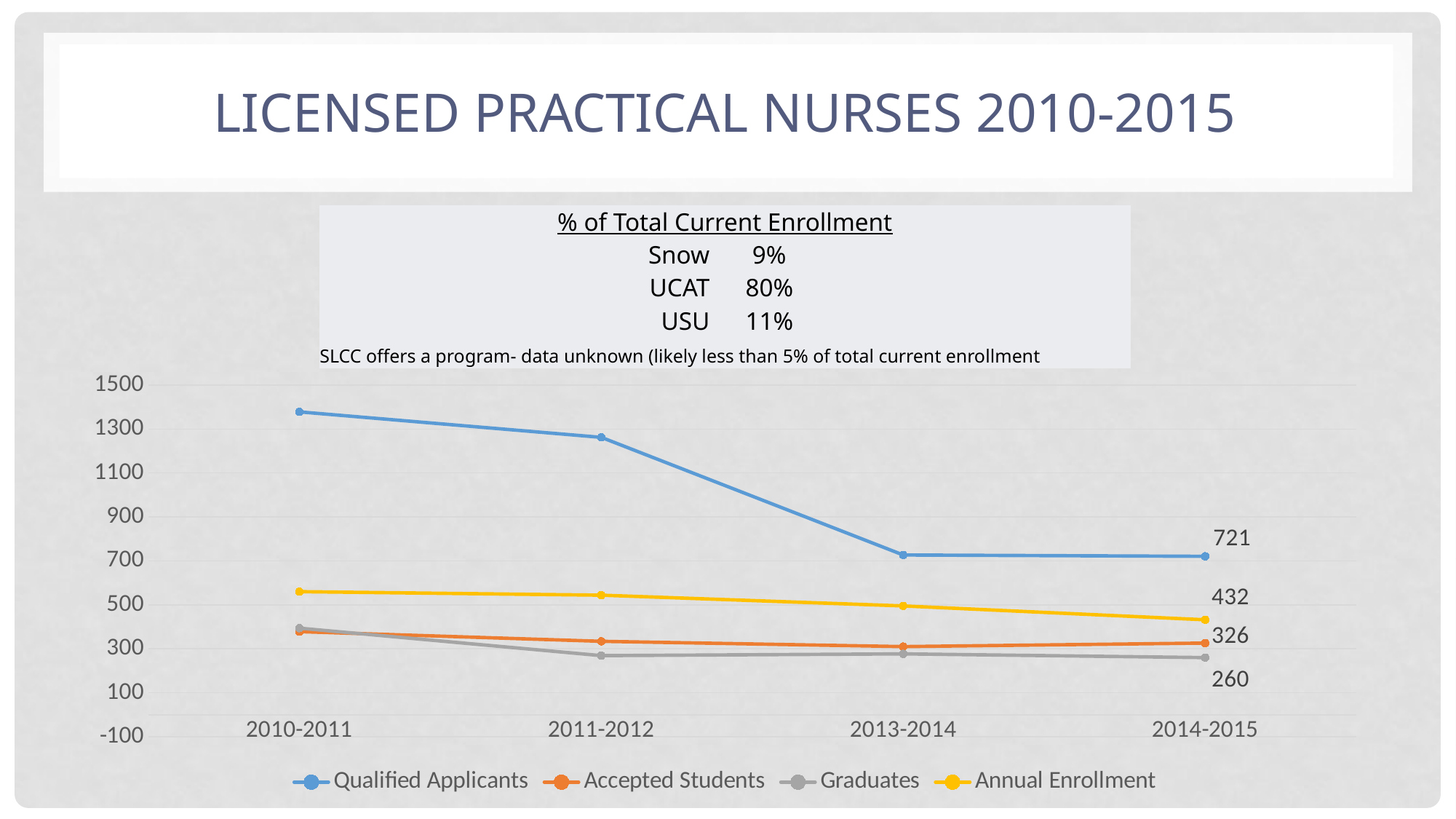
What type of chart is shown on the slide? line chart How many academic years are shown on the x axis? 4 What is the value for Accepted Students in 2014-2015? 326 What is the difference between Qualified Applicants and Annual Enrollment in 2014-2015? 289 What is the value for Graduates in 2014-2015? 260 Which series has the highest value in 2014-2015? Qualified Applicants What is the value for Annual Enrollment in 2014-2015? 432 Which series has the lowest value in 2014-2015? Graduates Is the value for Qualified Applicants in 2010-2011 greater or less than 1300? greater What is the value for Qualified Applicants in 2014-2015? 721 Does the Qualified Applicants line rise or fall from 2010-2011 to 2014-2015? fall How many series does the legend list? 4